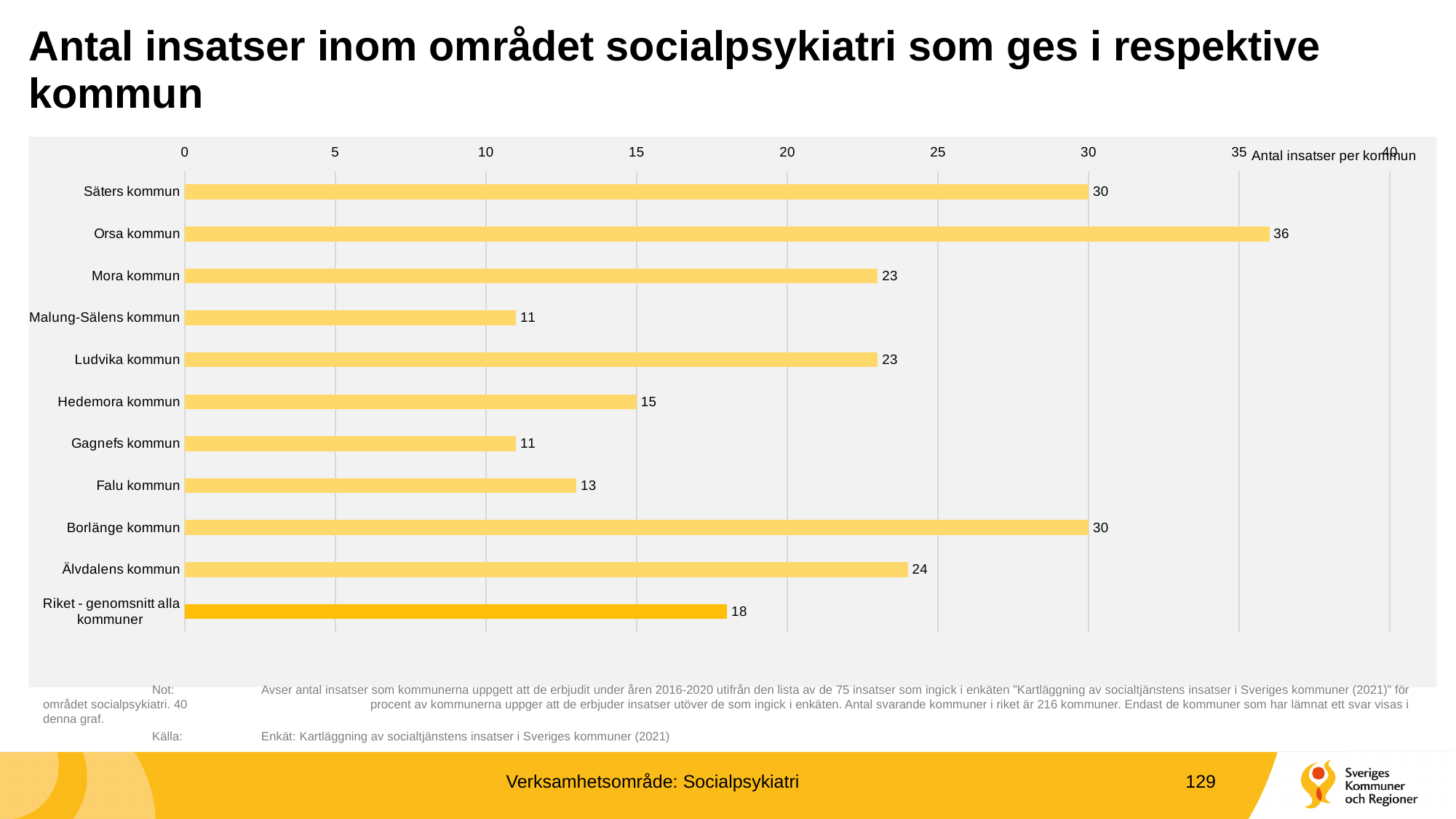
What is the value for Orsa kommun? 36 What is the difference between the values for Älvdalens kommun and Falu kommun? 11 Which is larger, the value for Borlänge kommun or the value for Älvdalens kommun? Borlänge kommun Which category has the highest value? Orsa kommun What is the value for Hedemora kommun? 15 What is the label shown at the top right of the chart's axis? Antal insatser per kommun What is the difference between the values for Orsa kommun and Säters kommun? 6 How many categories are shown on the chart? 11 What is the value for Riket - genomsnitt alla kommuner? 18 Is the value for Ludvika kommun greater or less than 20? greater What kind of chart is shown on the slide? bar chart Which is larger, the value for Mora kommun or the value for Hedemora kommun? Mora kommun